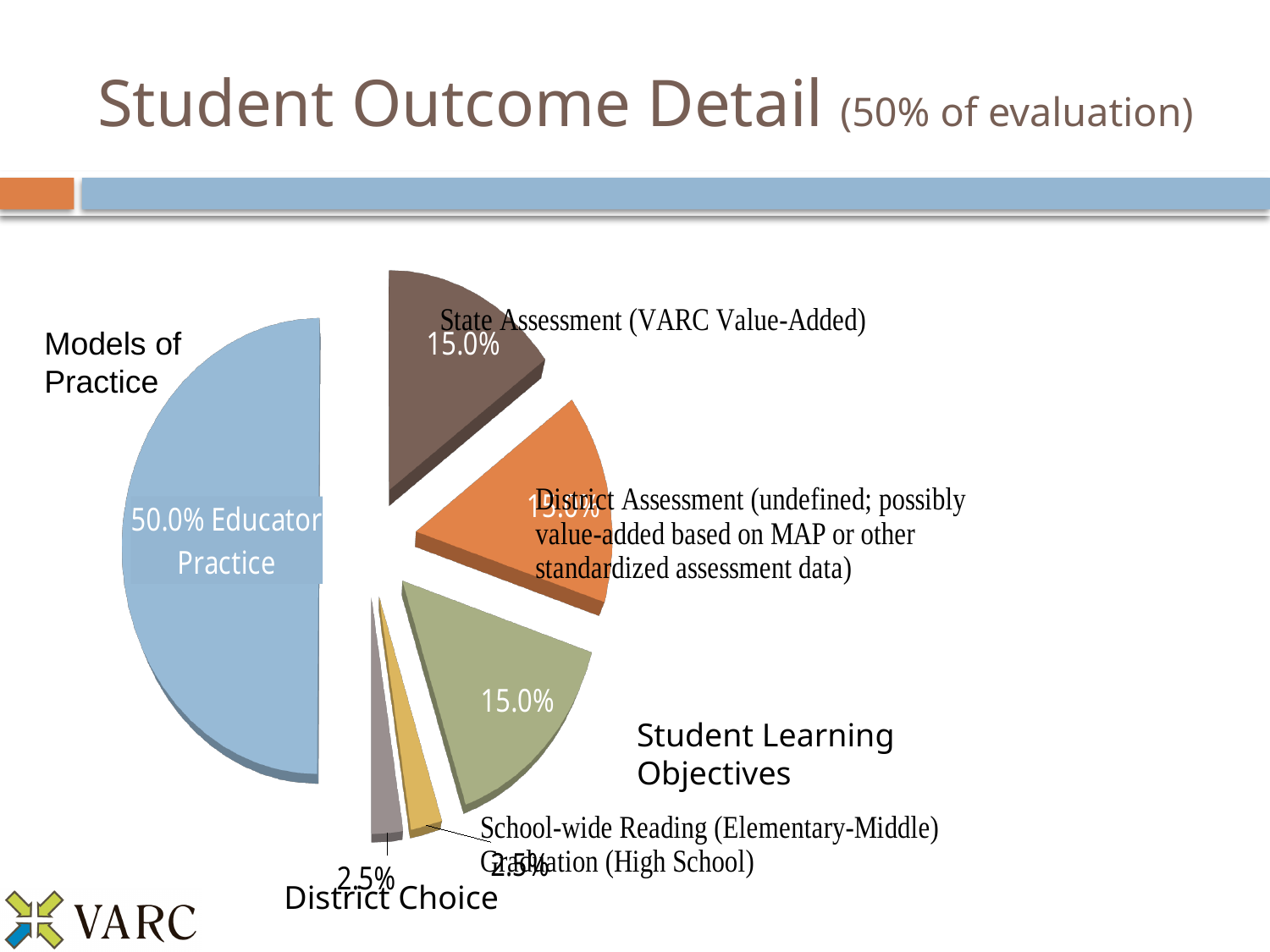
What percentage is shown for the Student Learning Objectives slice? 15.0% What is the difference between the Student Learning Objectives slice and the District Choice slice? 12.5% What colour is the Educator Practice slice? blue How many slices does the pie chart have? 6 What percentage is shown for the District Choice slice? 2.5% What percentage is shown for the State Assessment (VARC Value-Added) slice? 15.0% Which slice of the pie is the largest? Educator Practice Which is larger, the State Assessment slice or the District Choice slice? State Assessment What is the title of the slide containing the pie chart? Student Outcome Detail (50% of evaluation) What percentage of the pie is labelled Educator Practice? 50.0% What kind of chart is shown on the slide? pie chart What is the difference between the Educator Practice slice and the State Assessment slice? 35.0%